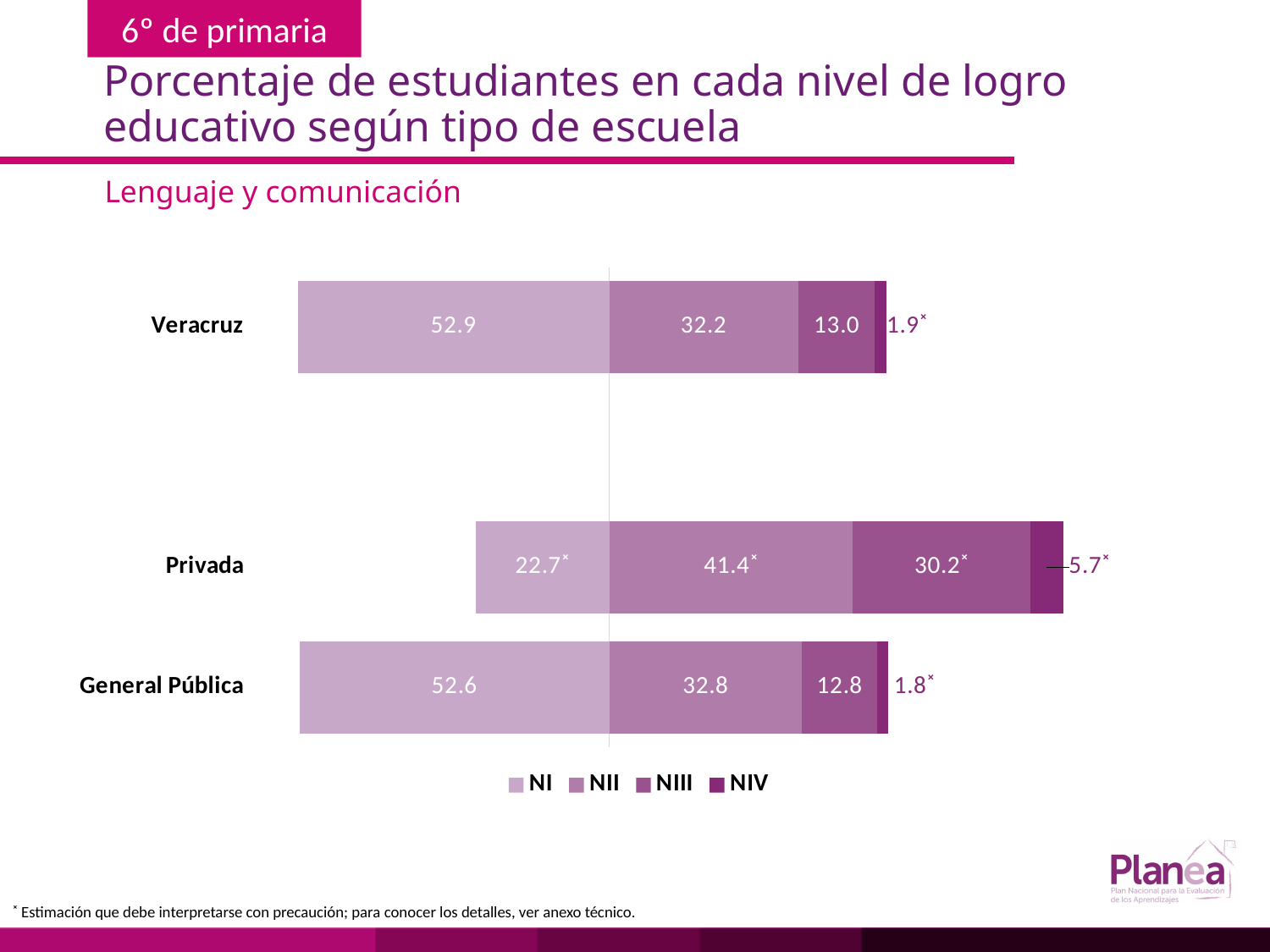
Which school type has the lowest NI percentage? Privada How many school types (categories) are shown in the chart? 3 What percentage of Veracruz students are at level NI in Lenguaje y comunicación? 52.9 What is the total of the stacked bar for Privada? 100.0 What kind of chart is shown on the slide? Stacked bar chart What is the difference between the NIII values for Privada and General Pública? 17.4 Which school type has the highest NI percentage? Veracruz What is the NIII value for Veracruz? 13.0 Which is larger, the NIV value for Privada or the NIV value for Veracruz? Privada What is the NII value for Privada schools? 41.4 How many series does the legend list? 4 What is the NIV value for General Pública schools? 1.8